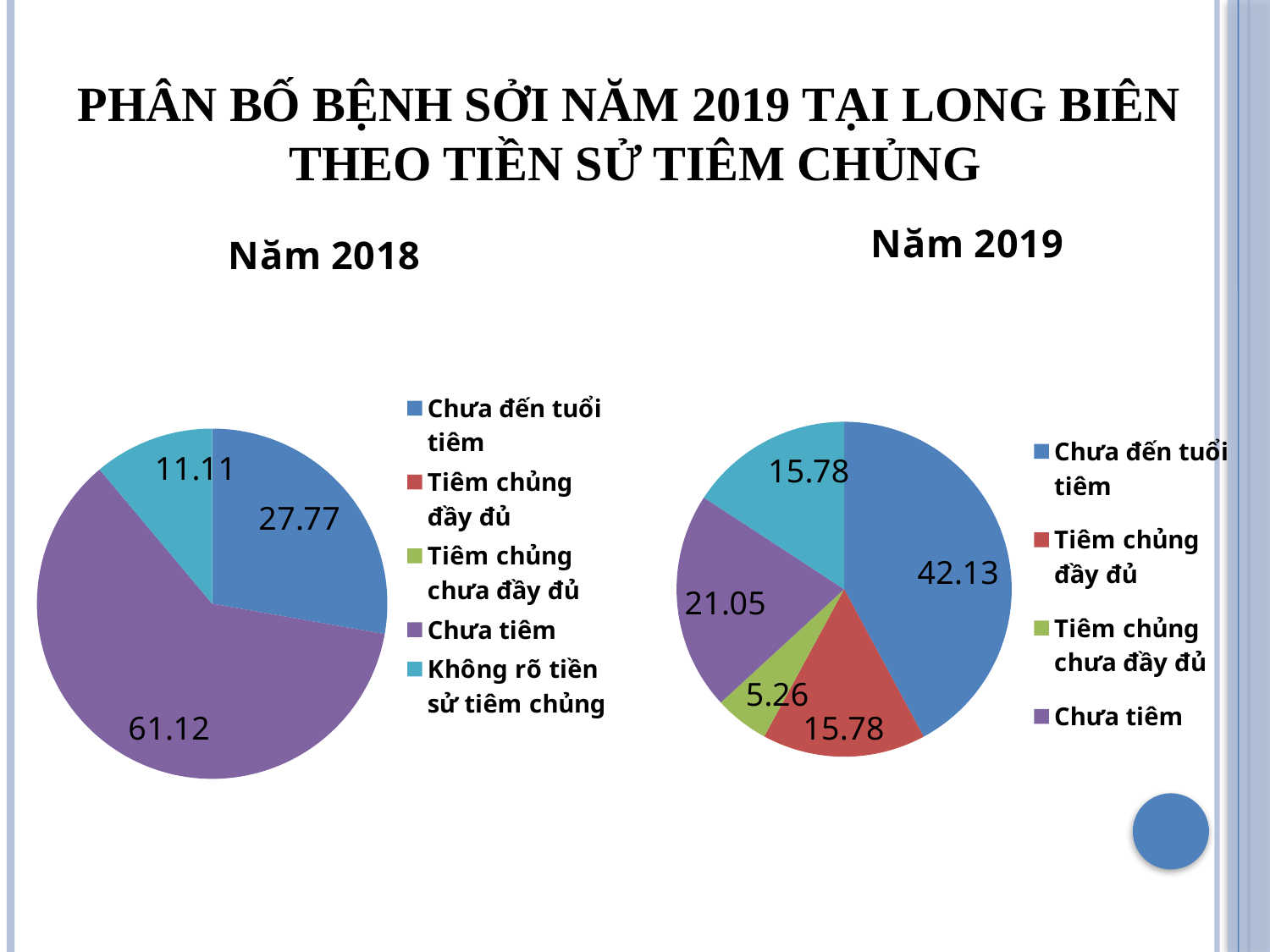
In the Năm 2019 pie chart, what is the difference between the values for Chưa đến tuổi tiêm and Chưa tiêm? 21.08 In the Năm 2018 pie chart, which category has the largest slice? Chưa tiêm In the Năm 2018 pie chart, what is the value for Chưa đến tuổi tiêm? 27.77 In the Năm 2019 pie chart, which category has the largest slice? Chưa đến tuổi tiêm In the Năm 2019 pie chart, what is the value for Chưa tiêm? 21.05 In the Năm 2018 pie chart, what is the value for Không rõ tiền sử tiêm chủng? 11.11 In the Năm 2019 pie chart, which category has the smallest slice? Tiêm chủng chưa đầy đủ In the Năm 2018 pie chart, what is the value for Chưa tiêm? 61.12 In the Năm 2019 pie chart, what is the value for Tiêm chủng đầy đủ? 15.78 In the Năm 2019 pie chart, what is the value for Chưa đến tuổi tiêm? 42.13 In the Năm 2019 pie chart, what is the value for Tiêm chủng chưa đầy đủ? 5.26 What kind of chart is used for Năm 2018 and Năm 2019 on this slide? Pie chart